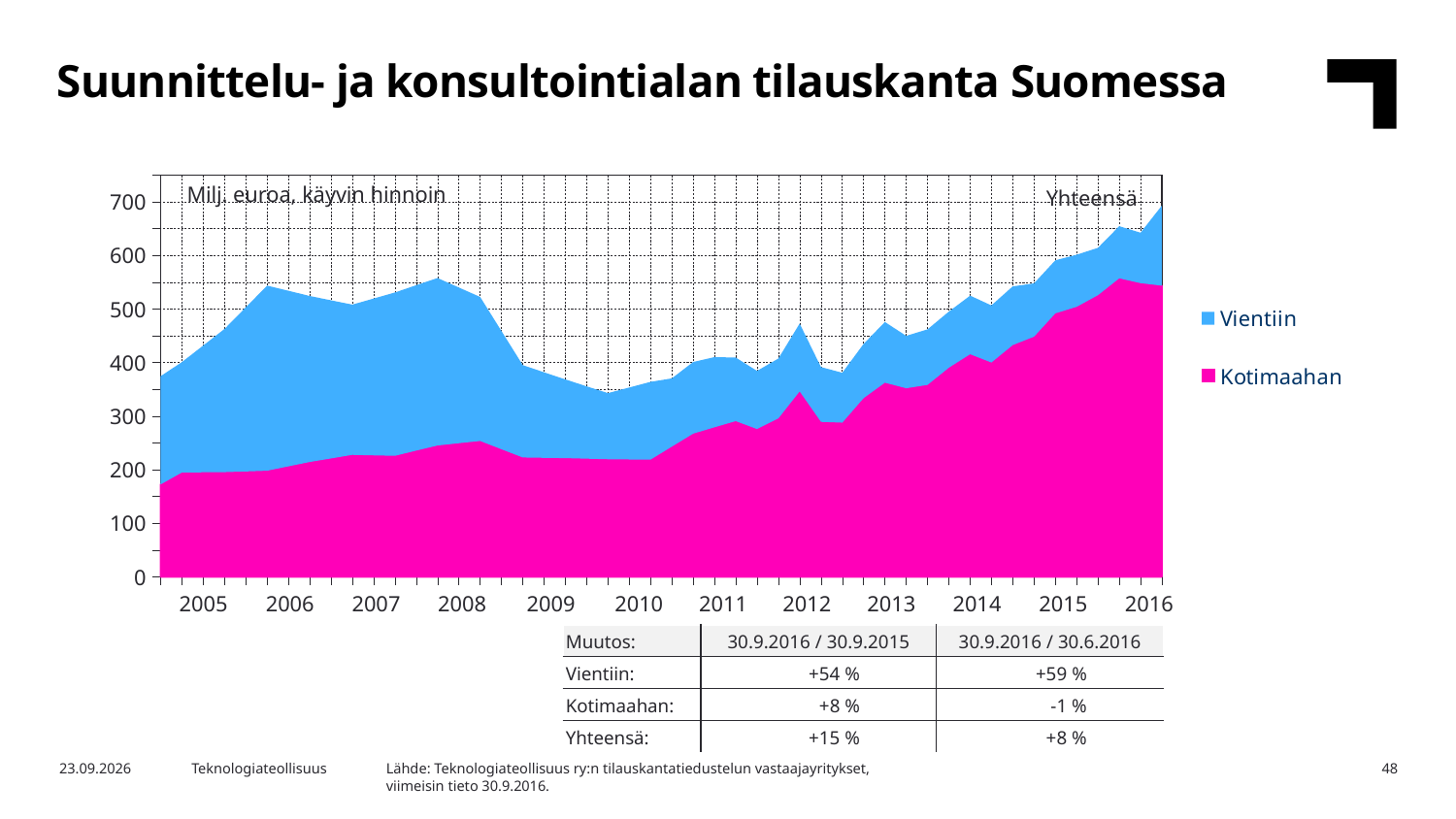
Is the total (Yhteensä) at 2016 greater or less than 600? greater At 2016, which series is larger, Vientiin or Kotimaahan? Kotimaahan Is the total (Yhteensä) at 2008 greater or less than 500? greater What type of chart is shown on the slide? area chart How many series does the legend list? 2 What unit is stated in the label at the top left of the chart? Milj. euroa, käyvin hinnoin Is the total (Yhteensä) at 2010 greater or less than 400? less How many years are labelled on the x axis? 12 Which two series are listed in the legend? Vientiin and Kotimaahan Does the value for Kotimaahan rise or fall from 2012 to 2016? rise